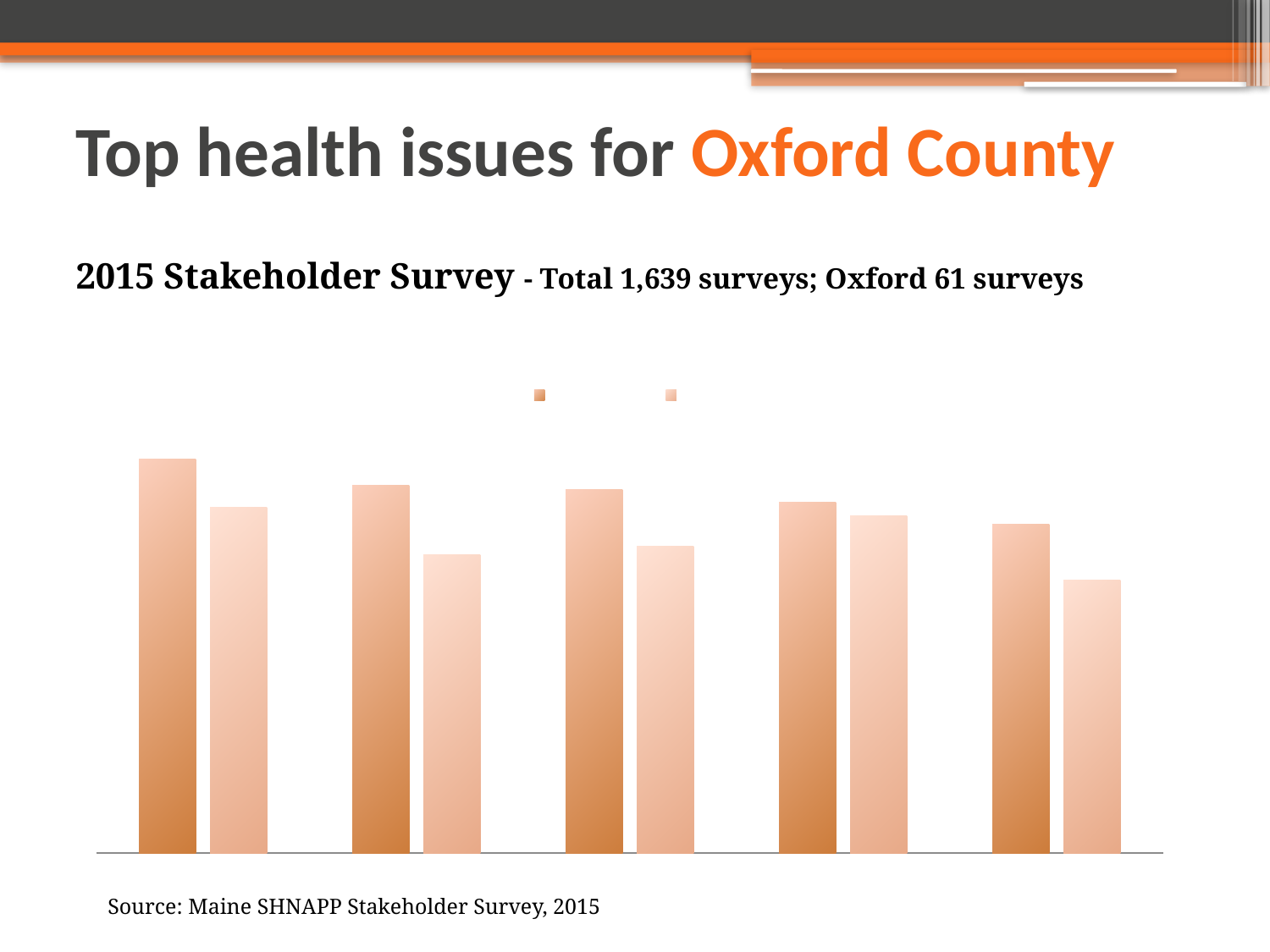
Which group of bars has the shortest lighter orange bar? The rightmost (fifth) group How many groups of bars are plotted in the chart? 5 Is the lighter orange bar shorter than the darker orange bar in every group? Yes What kind of chart is shown on the slide? Bar chart In the second group of bars from the left, which is taller: the darker orange bar or the lighter orange bar? The darker orange bar What source is cited below the chart? Maine SHNAPP Stakeholder Survey, 2015 In the leftmost group of bars, which is taller: the darker orange bar or the lighter orange bar? The darker orange bar Which group of bars has the shortest darker orange bar? The rightmost (fifth) group Which group of bars has the tallest darker orange bar? The leftmost (first) group Do the darker orange bars rise or fall from left to right across the chart? Fall Which group of bars has the tallest lighter orange bar? The leftmost (first) group How many series does the chart's legend list? 2